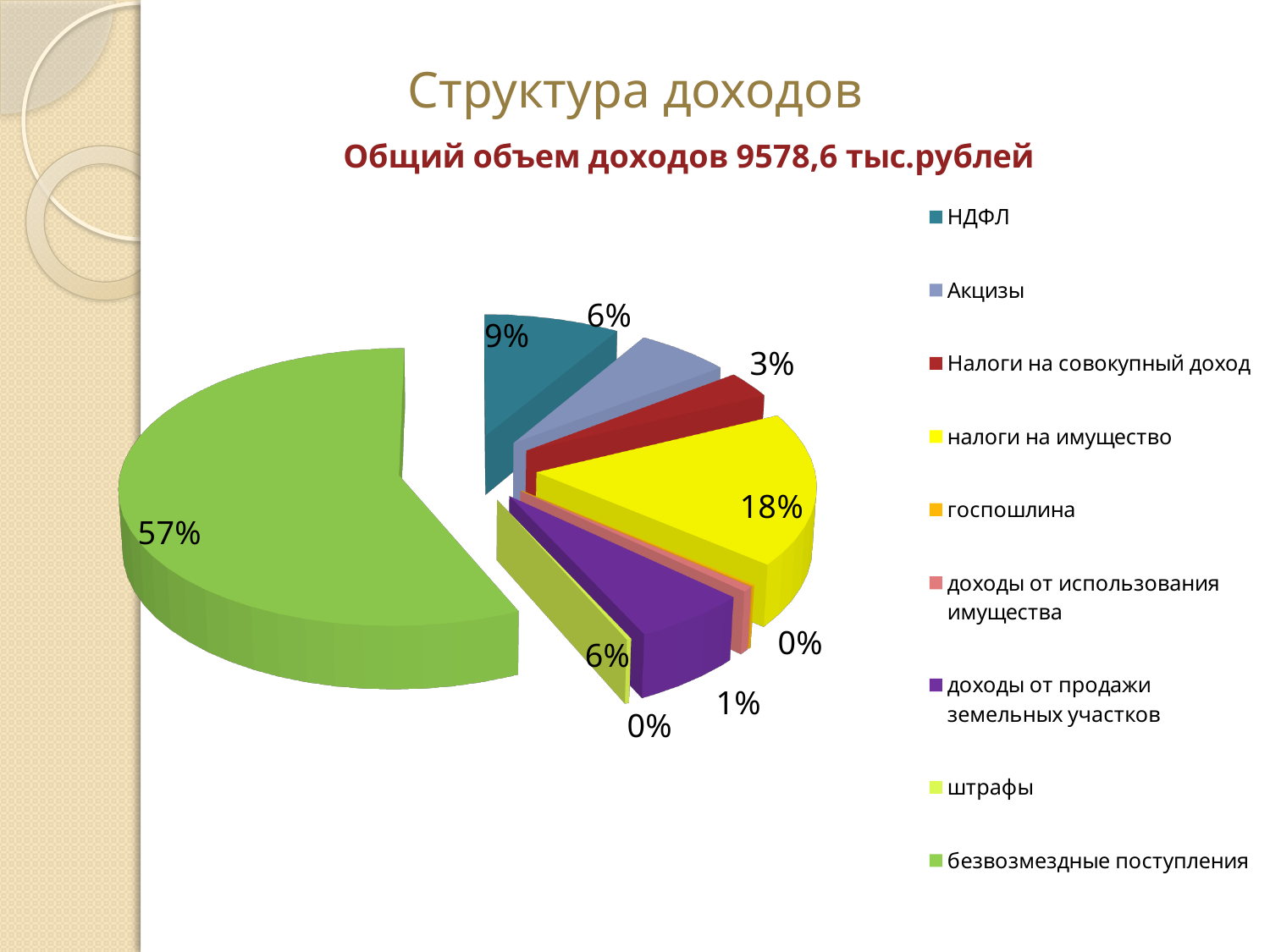
What is the difference in percentage points between the share for безвозмездные поступления and the share for налоги на имущество? 39 How many categories does the legend list? 9 What share of the pie does налоги на имущество have? 18% What share of the pie does Налоги на совокупный доход have? 3% What total income amount is stated above the chart? 9578,6 тыс.рублей What share of the pie does доходы от использования имущества have? 1% What is the title of the slide? Структура доходов Which category has the largest share of the pie? безвозмездные поступления Which is larger, the share for Акцизы or the share for Налоги на совокупный доход? Акцизы What kind of chart is shown on the slide? pie chart